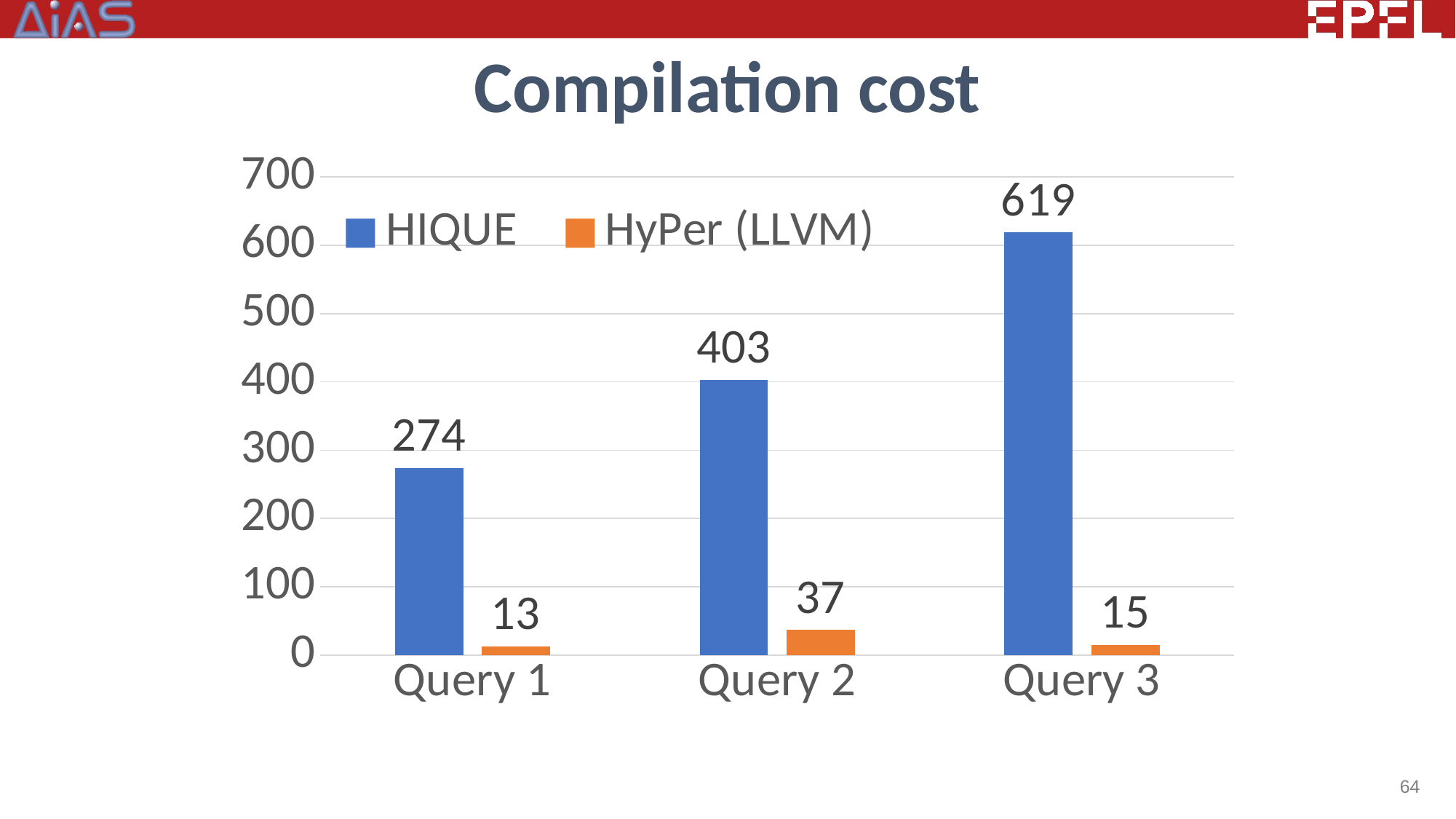
What is the difference between the HIQUE values for Query 3 and Query 2? 216 What is the HyPer (LLVM) value for Query 1? 13 Which is larger for Query 2: the HIQUE value or the HyPer (LLVM) value? HIQUE What is the HIQUE value for Query 2? 403 Do the HIQUE values rise or fall from Query 1 to Query 3? Rise How many series does the legend list? 2 Which query has the lowest HyPer (LLVM) value? Query 1 Which query has the highest HIQUE value? Query 3 How many queries are shown on the x axis? 3 What kind of chart is shown on the slide? Bar chart What is the difference between the HIQUE and HyPer (LLVM) values for Query 1? 261 What is the HIQUE value for Query 3? 619